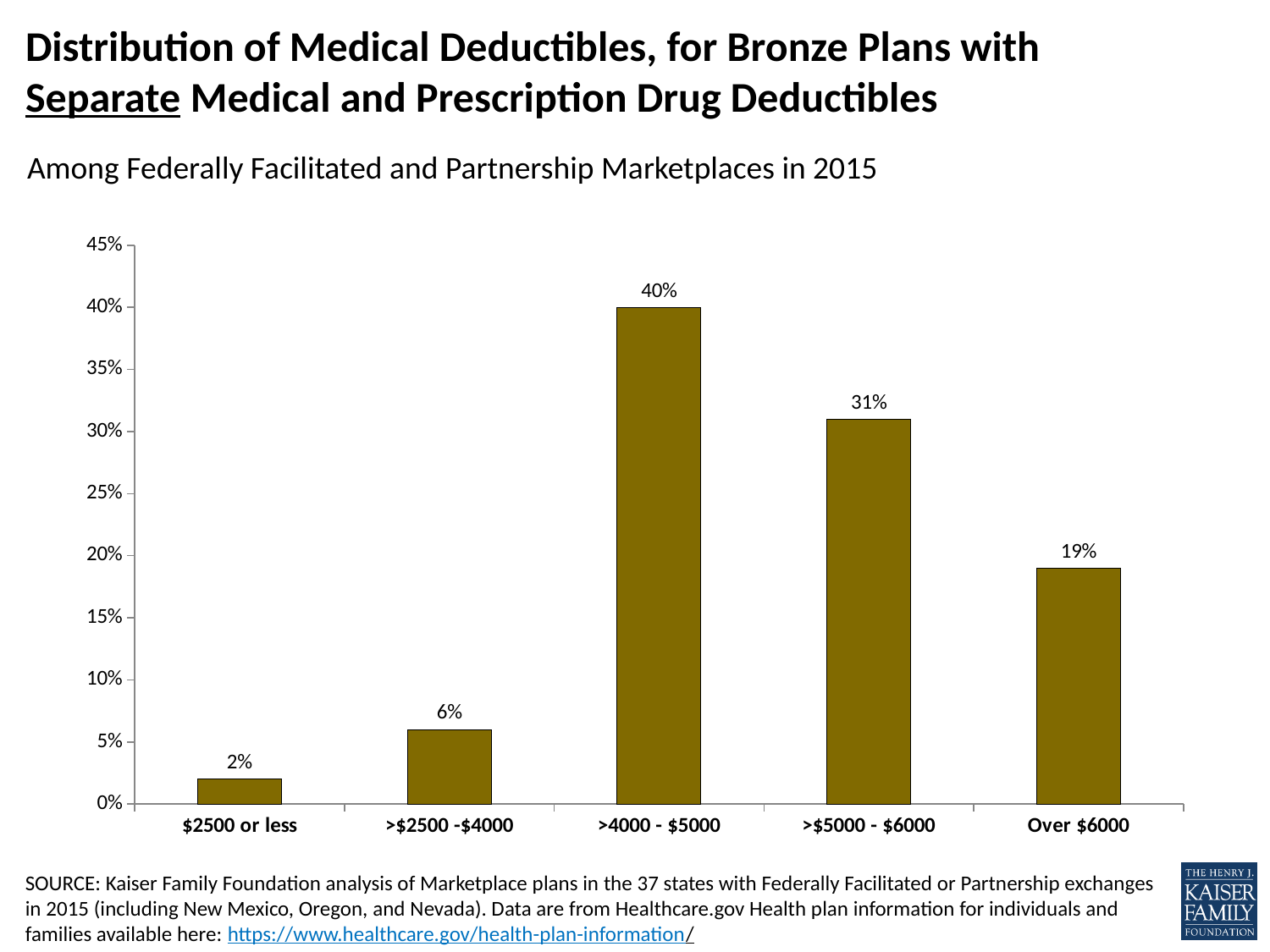
What share of plans fall in the >$5000 - $6000 deductible range? 31% How many deductible categories are shown on the x axis? 5 What is the difference in percentage points between the >$4000 - $5000 and >$5000 - $6000 categories? 9 percentage points Which deductible range has the highest share of plans? >4000 - $5000 Is the value for >$5000 - $6000 greater or less than 30%? greater What is the value shown for the >$2500 -$4000 category? 6% What is the maximum value shown on the vertical axis? 45% What kind of chart is shown on the slide? Bar chart What percentage of plans have a medical deductible over $6000? 19% What percentage of bronze plans with separate deductibles have a medical deductible of $2500 or less? 2% Which is larger, the share for Over $6000 or the share for >$2500 -$4000? Over $6000 Which deductible range has the lowest share of plans? $2500 or less